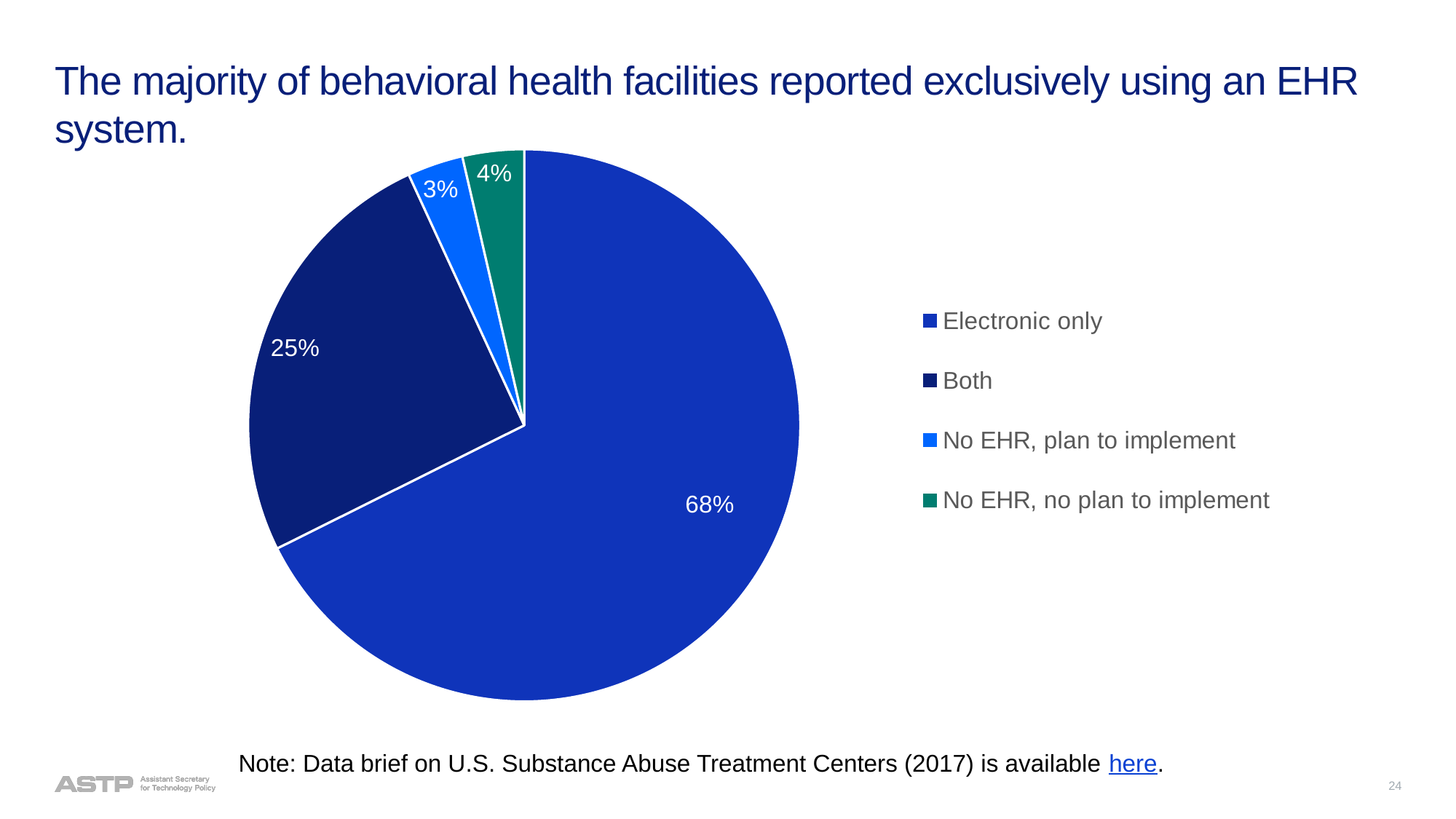
What is the combined share of facilities with no EHR (plan to implement plus no plan to implement)? 7% Which legend entry is shown in green? No EHR, no plan to implement Which category has the largest share of the pie? Electronic only What is the difference in percentage points between the Electronic only and Both categories? 43 How many categories are shown in the pie chart? 4 Which category has the smallest share of the pie? No EHR, plan to implement What percentage of facilities have no EHR but plan to implement one? 3% What share of behavioral health facilities reported using an electronic-only EHR system? 68% What percentage of facilities reported using both electronic and paper records? 25% What type of chart is shown on the slide? Pie chart Which is larger: the share for No EHR, no plan to implement or the share for No EHR, plan to implement? No EHR, no plan to implement What percentage of facilities have no EHR and no plan to implement one? 4%